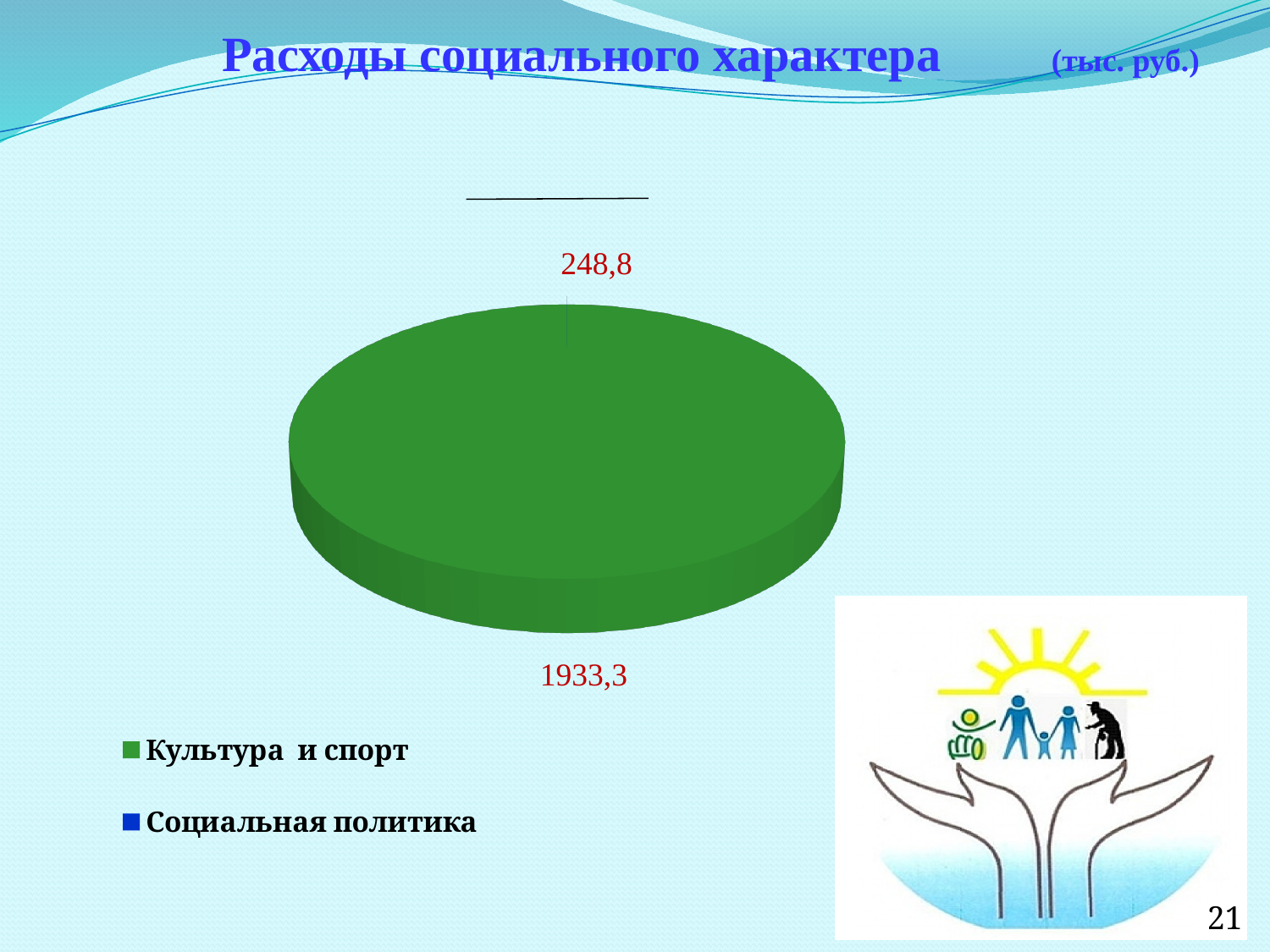
What value is shown for Культура и спорт on the pie chart? 1933,3 Which category takes up the smallest share of the pie chart? Социальная политика Which is larger on the pie chart: Культура и спорт or Социальная политика? Культура и спорт In what units are the values on the chart given, according to the slide? тыс. руб. What value is shown for Социальная политика on the pie chart? 248,8 What is the difference between the two values shown on the pie chart, 1933,3 and 248,8? 1684,5 What is the title of the chart on the slide? Расходы социального характера What colour represents Культура и спорт in the legend? green How many categories does the legend of the pie chart list? 2 What is the total of the two values shown on the pie chart? 2182,1 Which category takes up the largest share of the pie chart? Культура и спорт What kind of chart is shown on the slide? pie chart